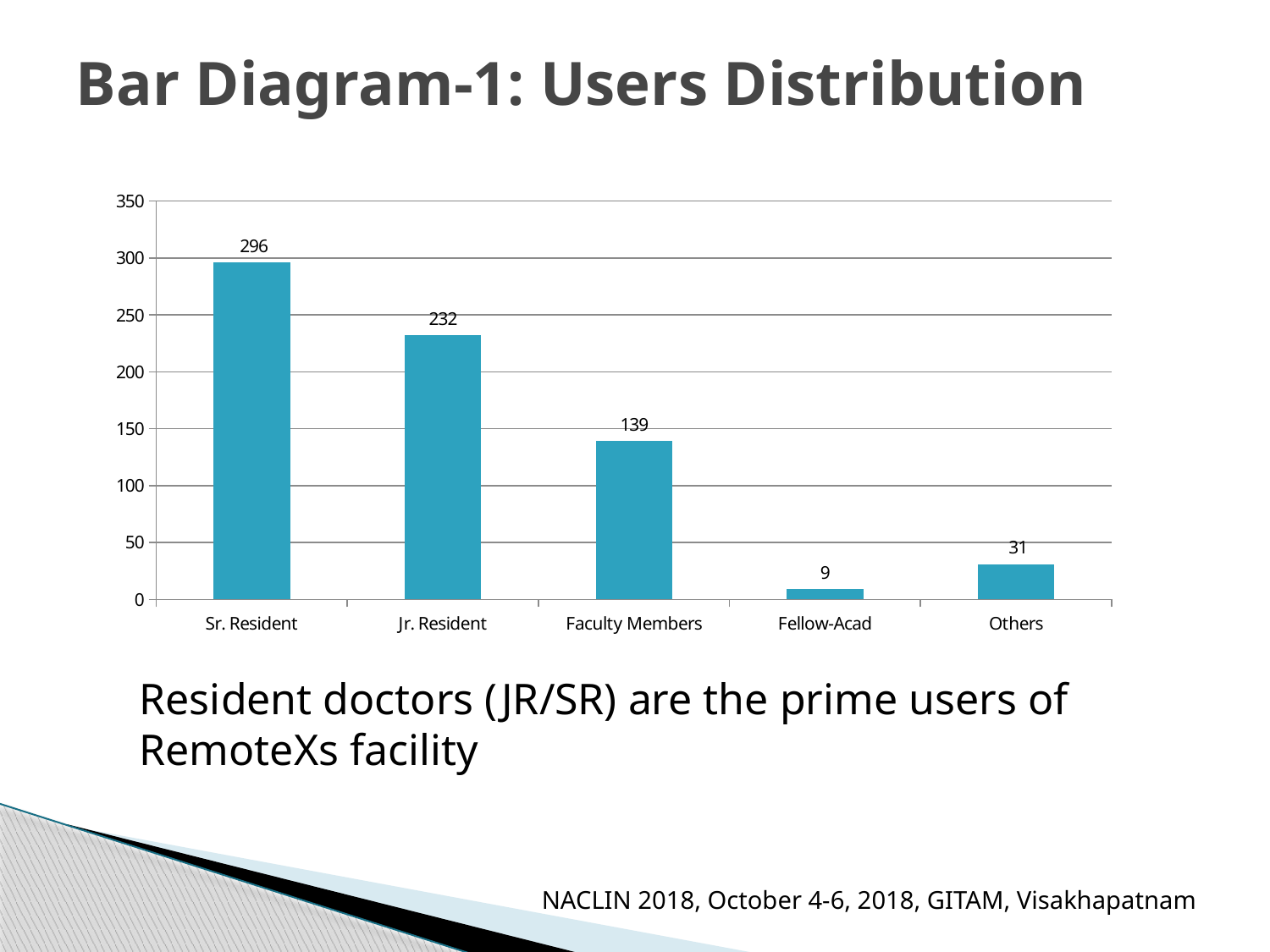
What is the value for Fellow-Acad? 9 Which category has the lowest value? Fellow-Acad Which is larger, the value for Jr. Resident or the value for Faculty Members? Jr. Resident What kind of chart is shown on the slide? bar chart What is the value for Sr. Resident? 296 Which category has the highest value? Sr. Resident How many categories are shown on the x axis? 5 What is the difference between the values for Others and Fellow-Acad? 22 Is the value for Faculty Members greater or less than 150? less What is the title of the slide containing the chart? Bar Diagram-1: Users Distribution What is the value for Faculty Members? 139 What is the difference between the values for Sr. Resident and Jr. Resident? 64